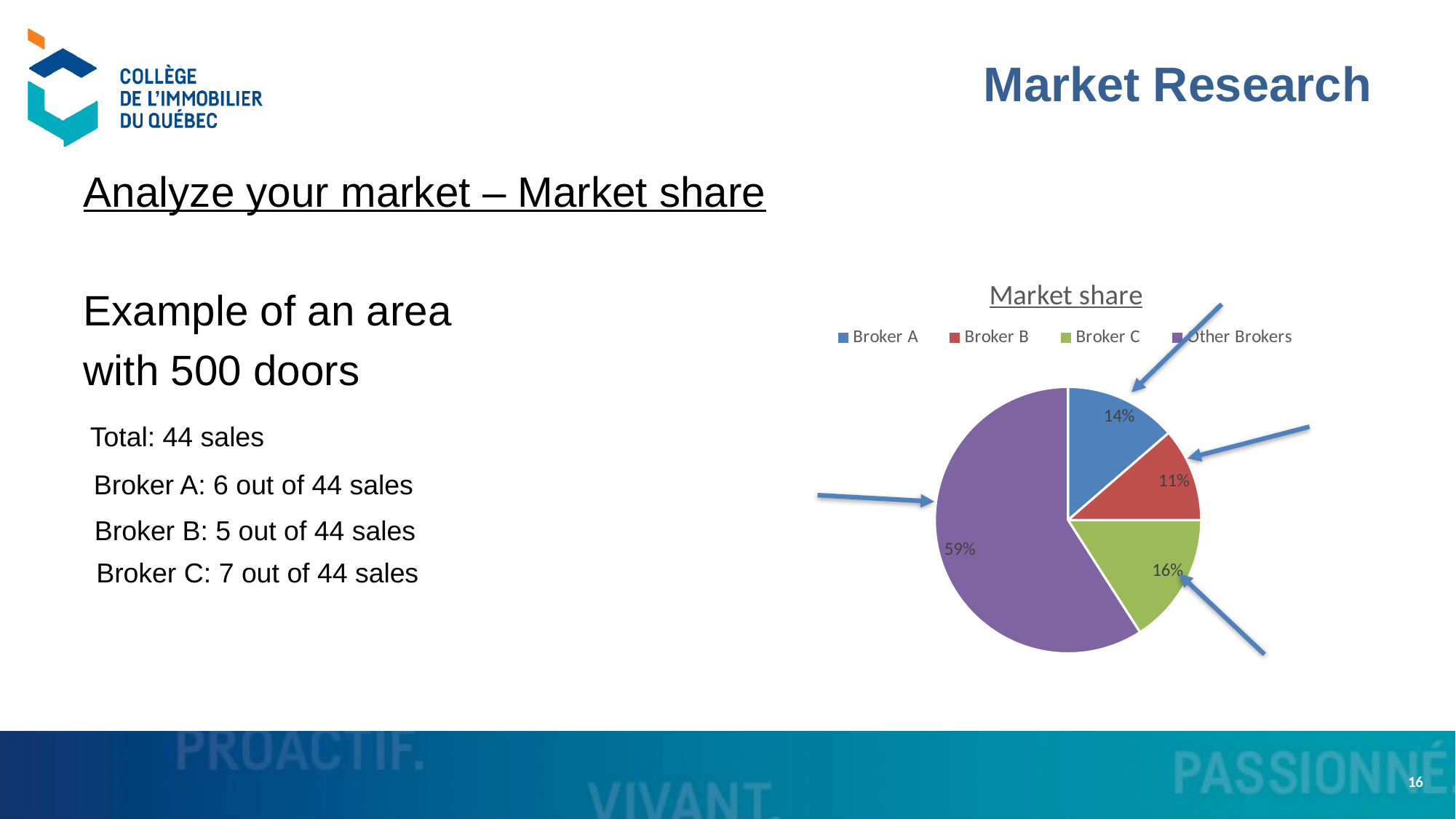
What is the difference in percentage points between the Other Brokers slice and the Broker C slice? 43 What share of the pie does Broker B have? 11% Which has a larger share, Broker A or Broker C? Broker C What share of the pie does Broker C have? 16% What is the title of the chart? Market share What kind of chart is shown on the slide? pie chart How many slices does the pie chart have? 4 Which category has the smallest slice of the pie? Broker B Which category has the largest slice of the pie? Other Brokers What share of the pie does Broker A have? 14% How many entries does the chart legend list? 4